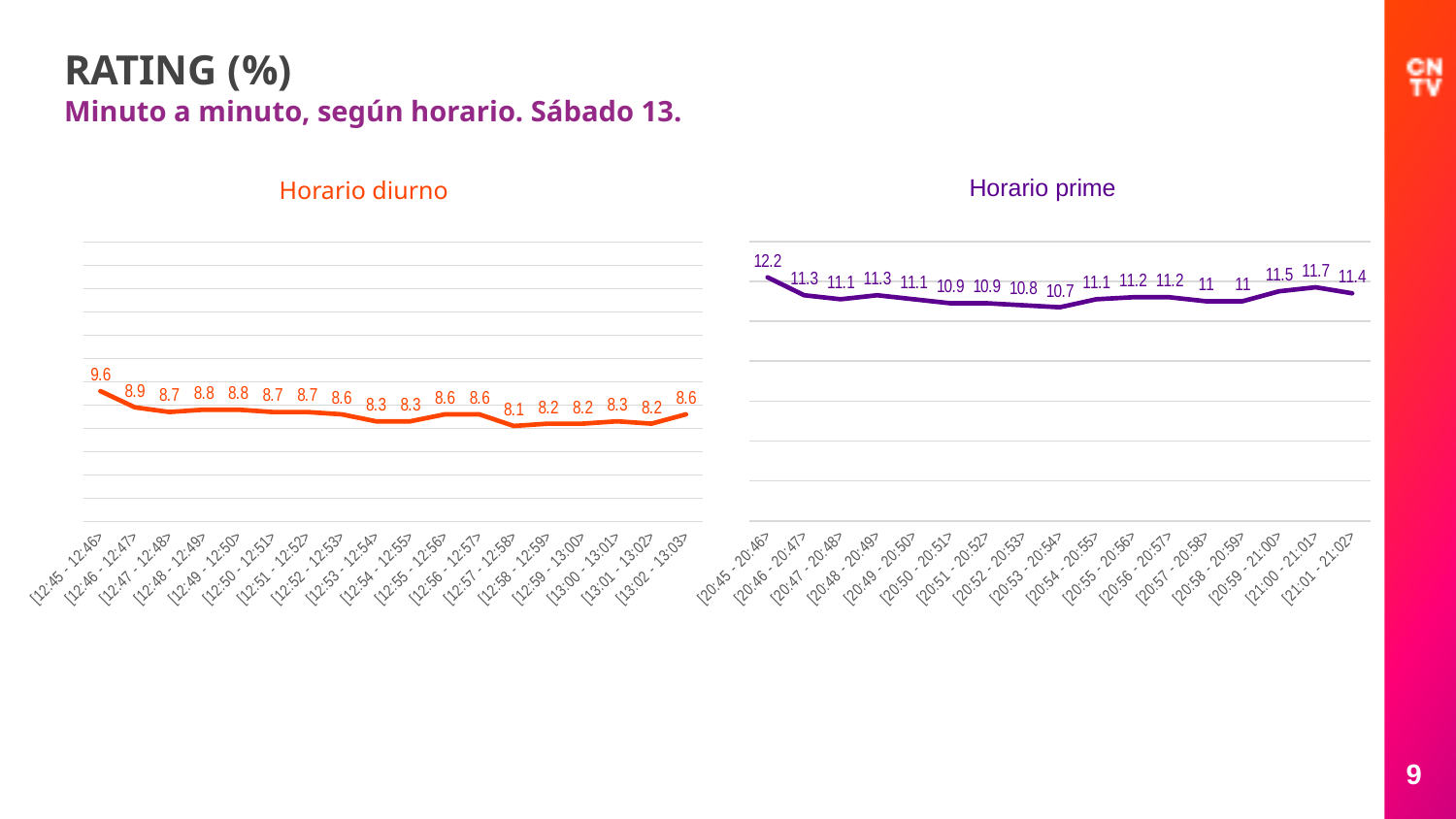
What type of chart is used for the Horario diurno data? Line chart What colour is the line in the Horario diurno chart? Orange In the Horario diurno chart, what is the lowest rating value shown? 8.1 How many time intervals are plotted in the Horario prime chart? 17 In the Horario prime chart, what is the lowest rating value shown? 10.7 In the Horario diurno chart, what is the rating for [12:45 - 12:46>? 9.6 In the Horario prime chart, what is the rating for [21:00 - 21:01>? 11.7 In the Horario prime chart, what is the difference between the rating at [20:45 - 20:46> and the rating at [21:01 - 21:02>? 0.8 In the Horario prime chart, which time interval has the highest rating? [20:45 - 20:46> In the Horario diurno chart, which time interval has the lowest rating? [12:57 - 12:58> How many time intervals are plotted in the Horario diurno chart? 18 Which chart has the higher peak rating, Horario diurno or Horario prime? Horario prime